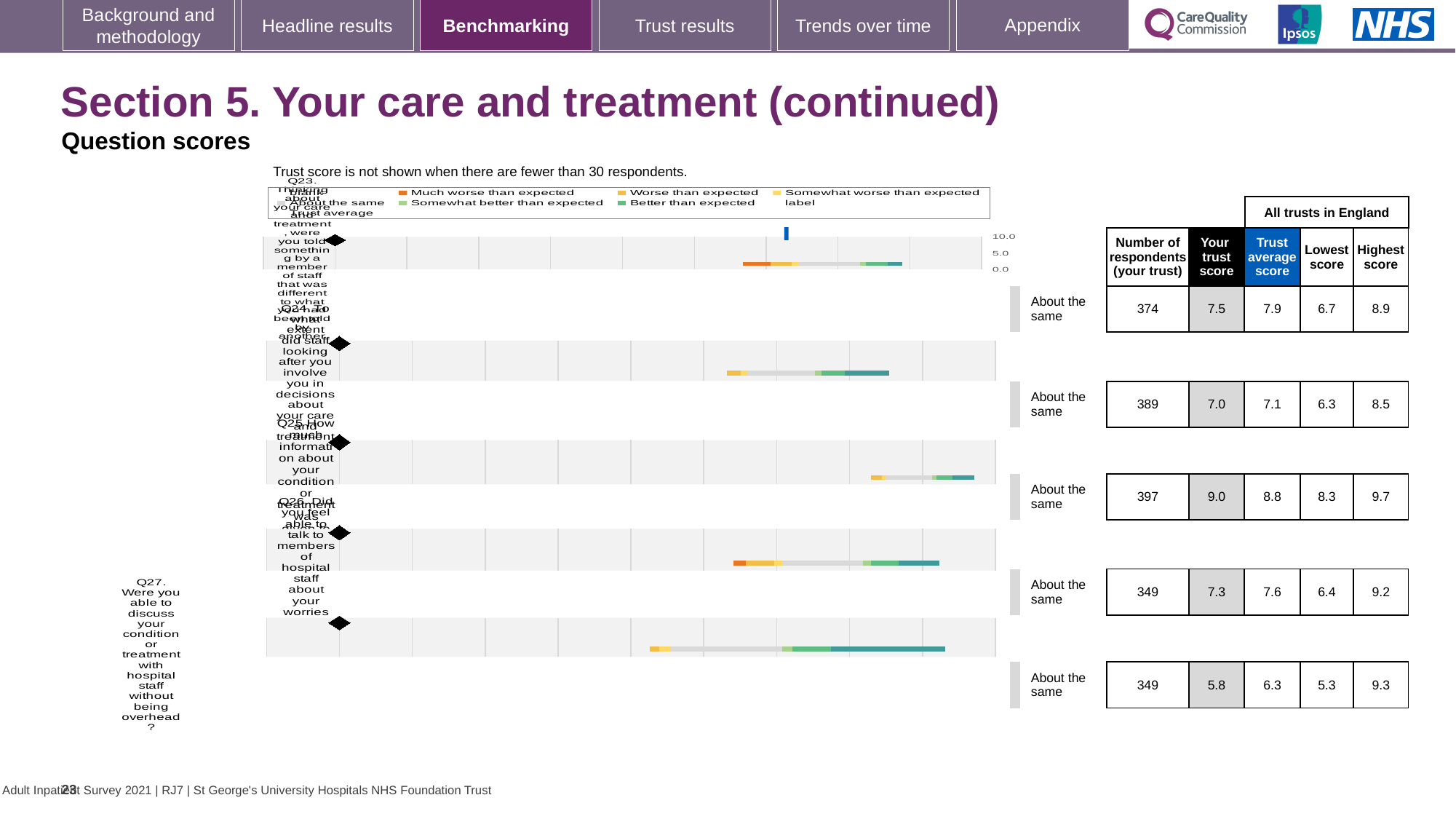
Which has the higher trust score, Q23 or Q24? Q23 What is the trust score for Q25? 9.0 How many questions (Q23 to Q27) are plotted in the chart? 5 Which colour in the legend represents 'Much worse than expected'? orange What is the difference between the trust scores for Q25 and Q27? 3.2 Which question has the highest trust score? Q25 What is the trust score for Q27 (discussing your condition or treatment without being overheard)? 5.8 What kind of chart is used to show the question scores on this slide? bar chart What is the trust average score (all trusts in England) for Q26? 7.6 What is the highest value shown on the chart's score axis? 10.0 Which question has the lowest trust score? Q27 How many respondents answered Q25 for this trust? 397